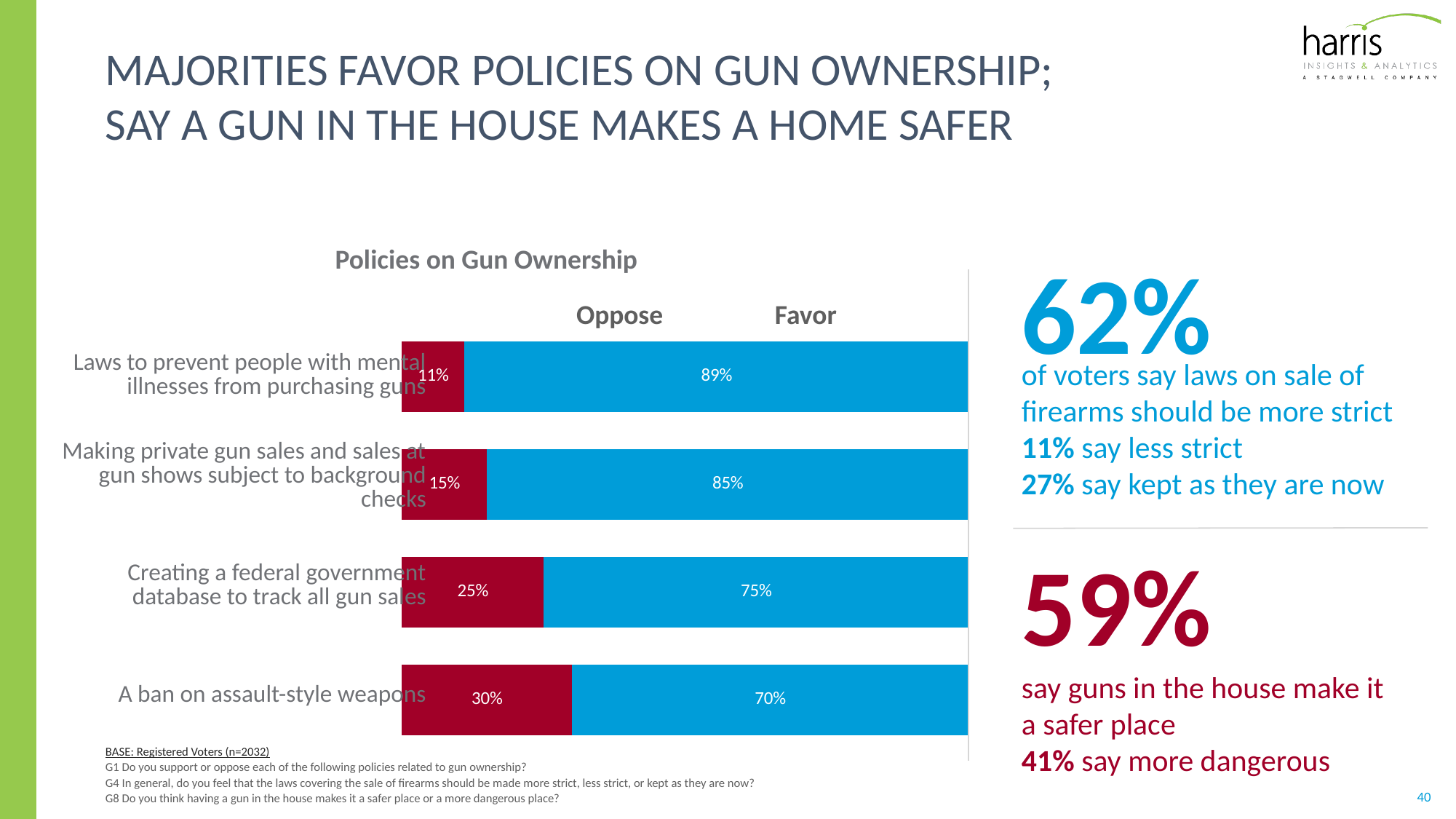
What colour represents the Oppose series? Red Which policy has the highest Favor percentage? Laws to prevent people with mental illnesses from purchasing guns How many policies are shown in the Policies on Gun Ownership chart? 4 What percentage oppose making private gun sales and sales at gun shows subject to background checks? 15% What percentage oppose a ban on assault-style weapons? 30% What percentage favor creating a federal government database to track all gun sales? 75% What type of chart is used for Policies on Gun Ownership? Bar chart Which policy has the lowest Favor percentage? A ban on assault-style weapons What is the difference between the Favor percentages for background checks and a ban on assault-style weapons? 15% Which has a higher Oppose percentage: a federal government database to track all gun sales or a ban on assault-style weapons? A ban on assault-style weapons How many series does the chart show? 2 What percentage favor laws to prevent people with mental illnesses from purchasing guns? 89%